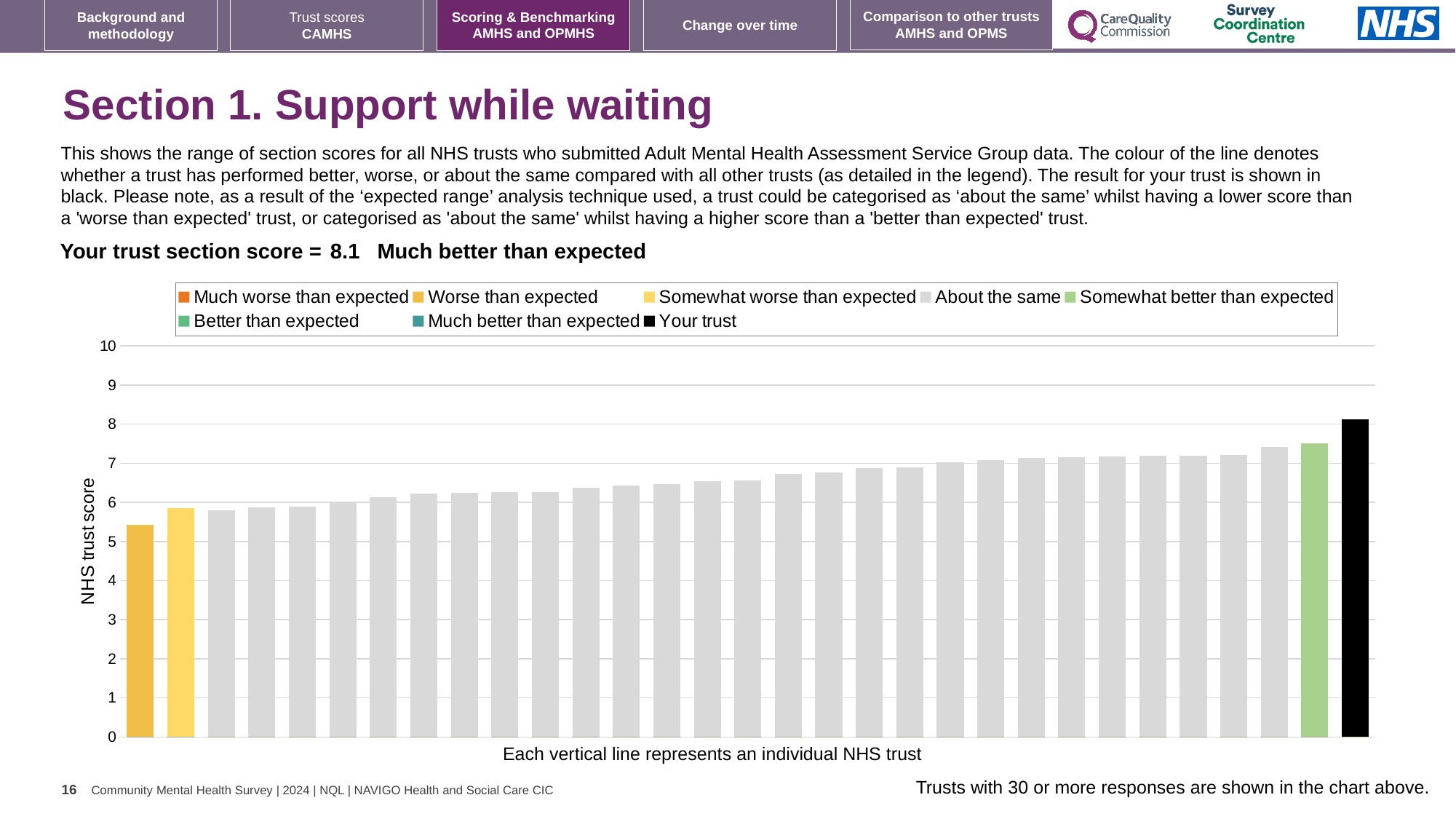
How many entries does the chart legend list? 8 What kind of chart is shown on the slide? bar chart Which is larger: the black 'Your trust' bar or the green 'Somewhat better than expected' bar? the black 'Your trust' bar What is the section score for your trust, as stated on the slide? 8.1 Is the value of the black 'Your trust' bar greater or less than 7? greater Which category does the slide say your trust's section score falls into? Much better than expected Do the bar values rise or fall from left to right across the chart? rise Which legend category does the lowest bar in the chart belong to? Worse than expected What is the label on the vertical axis of the chart? NHS trust score Is the value of the leftmost bar greater or less than 6? less Is the value of the green 'Somewhat better than expected' bar greater or less than 8? less Which bar in the chart is the highest? Your trust (the black bar)